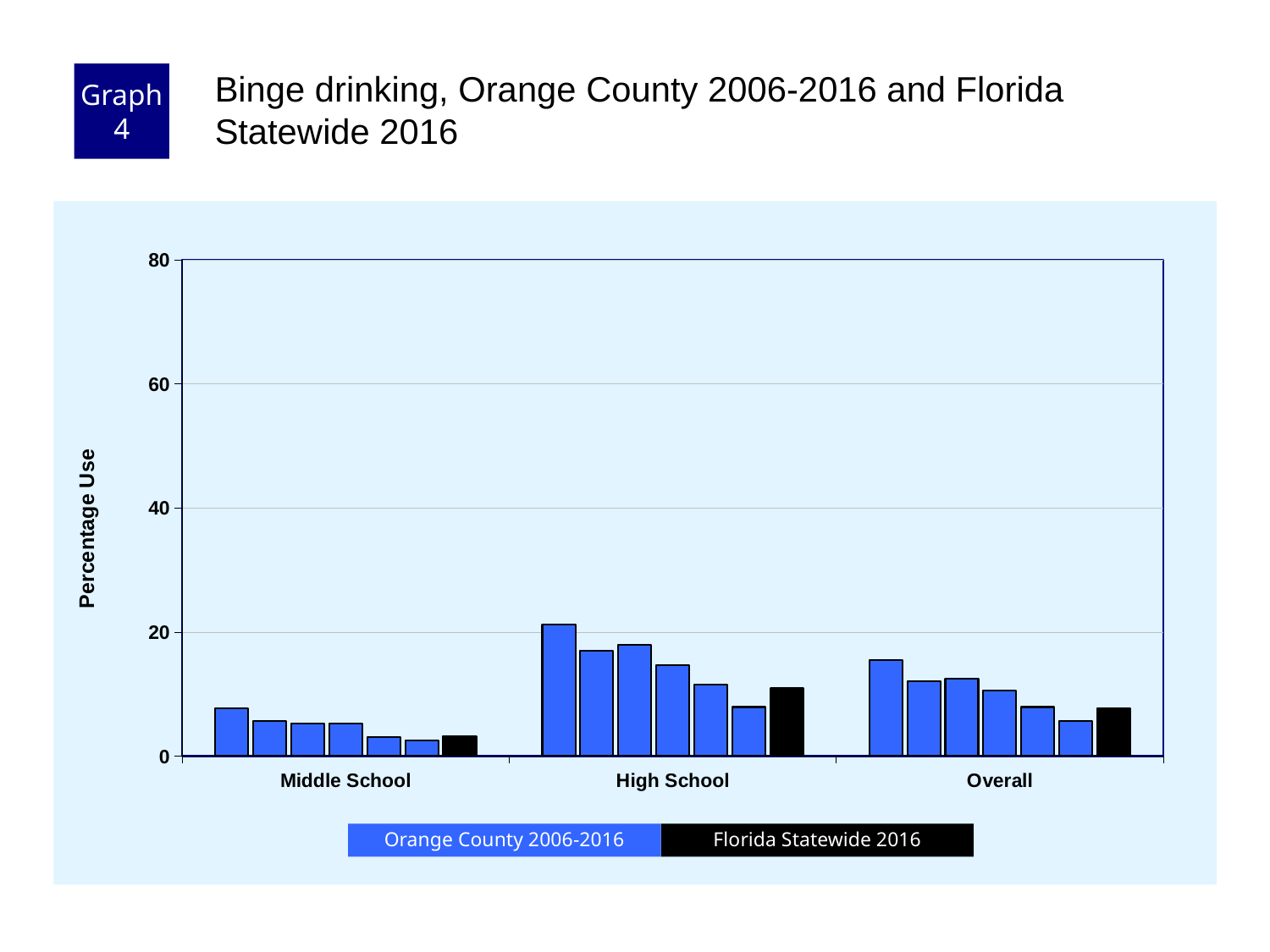
What kind of chart is shown on the slide? Bar chart Is the Florida Statewide 2016 value for High School greater or less than 20? less Which colour represents Florida Statewide 2016 in the legend? Black Is the Florida Statewide 2016 value for Middle School greater or less than 20? less What is the label on the y axis? Percentage Use Which category has the shortest bars overall? Middle School Is the Florida Statewide 2016 bar for Overall larger or smaller than the Florida Statewide 2016 bar for High School? smaller How many categories are shown on the x axis? 3 Is the Florida Statewide 2016 value for High School larger or smaller than the Florida Statewide 2016 value for Middle School? larger Which category has the tallest bars overall? High School Do the Orange County 2006-2016 bars for High School generally rise or fall from left to right? fall How many series does the legend list? 2